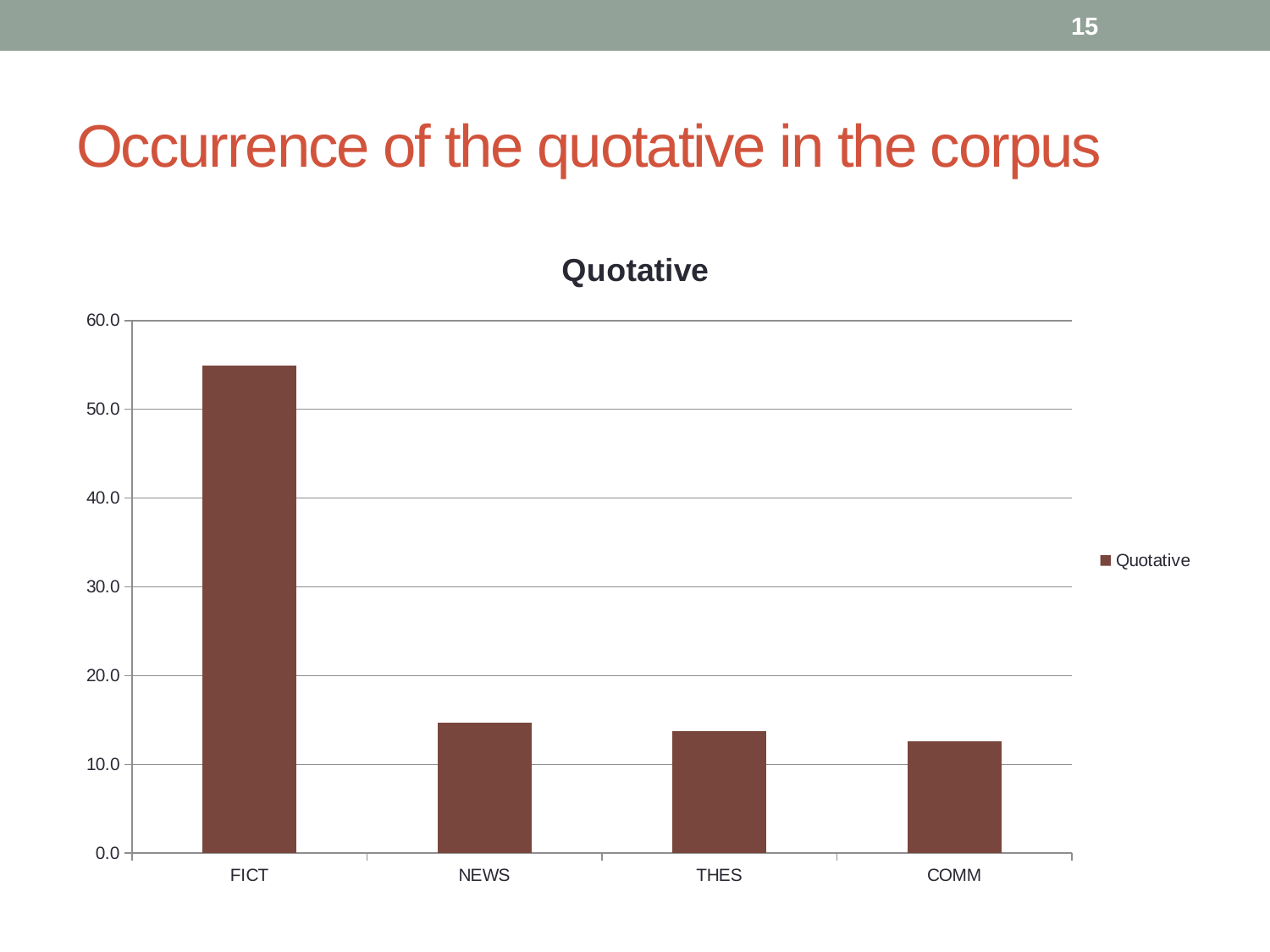
Which is larger, the value for FICT or the value for NEWS? FICT How many series does the legend list? 1 Is the value for NEWS greater or less than 10.0? greater Is the value for THES greater or less than 20.0? less Which category has the highest value? FICT What is the title of the chart? Quotative Is the value for FICT greater or less than 60.0? less What kind of chart is shown on the slide? bar chart Do the values rise or fall from left to right along the x axis? fall How many categories are shown on the x axis of the chart? 4